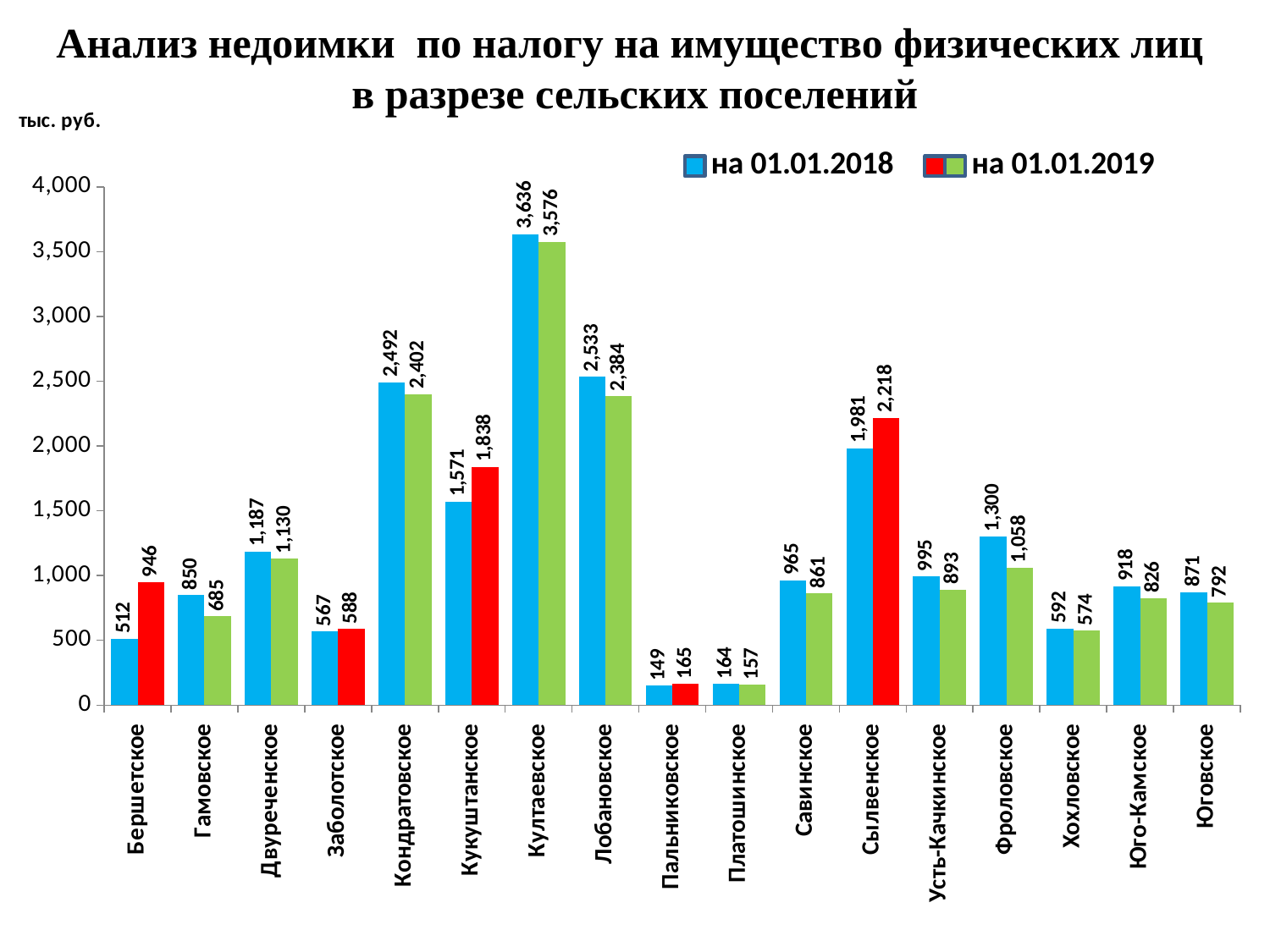
How many settlements are shown on the x axis? 17 What is the value for Култаевское on 01.01.2018? 3,636 What is the value for Сылвенское on 01.01.2019? 2,218 Which is larger for Кукуштанское: the value on 01.01.2018 or on 01.01.2019? на 01.01.2019 What kind of chart is shown on the slide? bar chart How many series does the legend list? 2 Which settlement has the lowest value on 01.01.2018? Пальниковское What is the difference between the 01.01.2019 and 01.01.2018 values for Бершетское? 434 What is the value for Бершетское on 01.01.2018? 512 Which settlement has the highest value on 01.01.2019? Култаевское What is the difference between the 01.01.2018 and 01.01.2019 values for Фроловское? 242 Is the value for Лобановское on 01.01.2018 greater or less than 2,500? greater